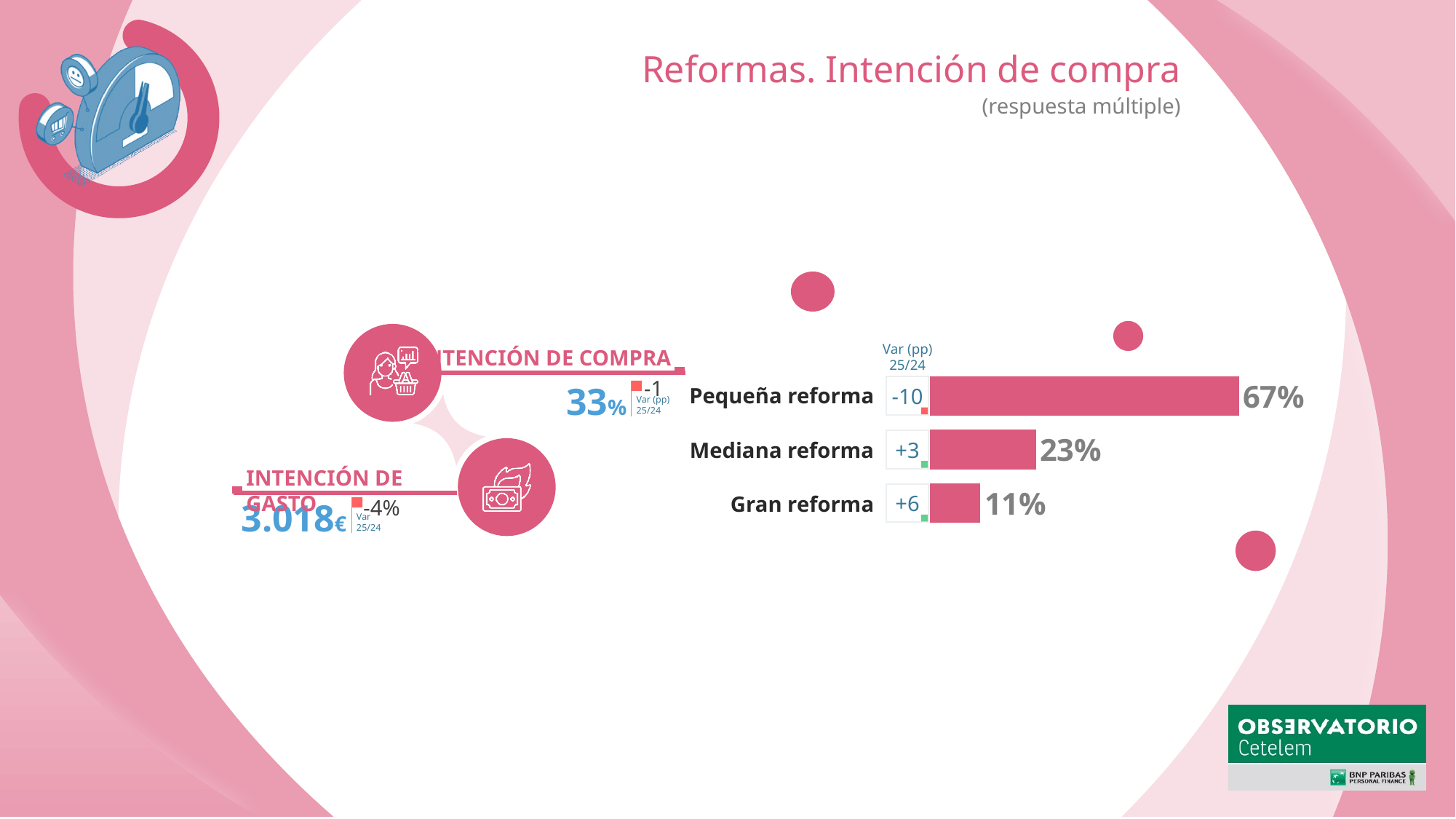
What is the difference between the values for Pequeña reforma and Mediana reforma? 44 percentage points How many categories are shown in the bar chart? 3 Which category has the lowest value? Gran reforma What is the value for Gran reforma? 11% What is the Var (pp) 25/24 shown for Gran reforma? +6 What is the difference between the values for Mediana reforma and Gran reforma? 12 percentage points What is the value for Mediana reforma? 23% What is the Var (pp) 25/24 shown for Pequeña reforma? -10 Which category has the highest value? Pequeña reforma What kind of chart is used to show the reform categories? Bar chart Which is larger, the value for Mediana reforma or Gran reforma? Mediana reforma What is the value for Pequeña reforma? 67%